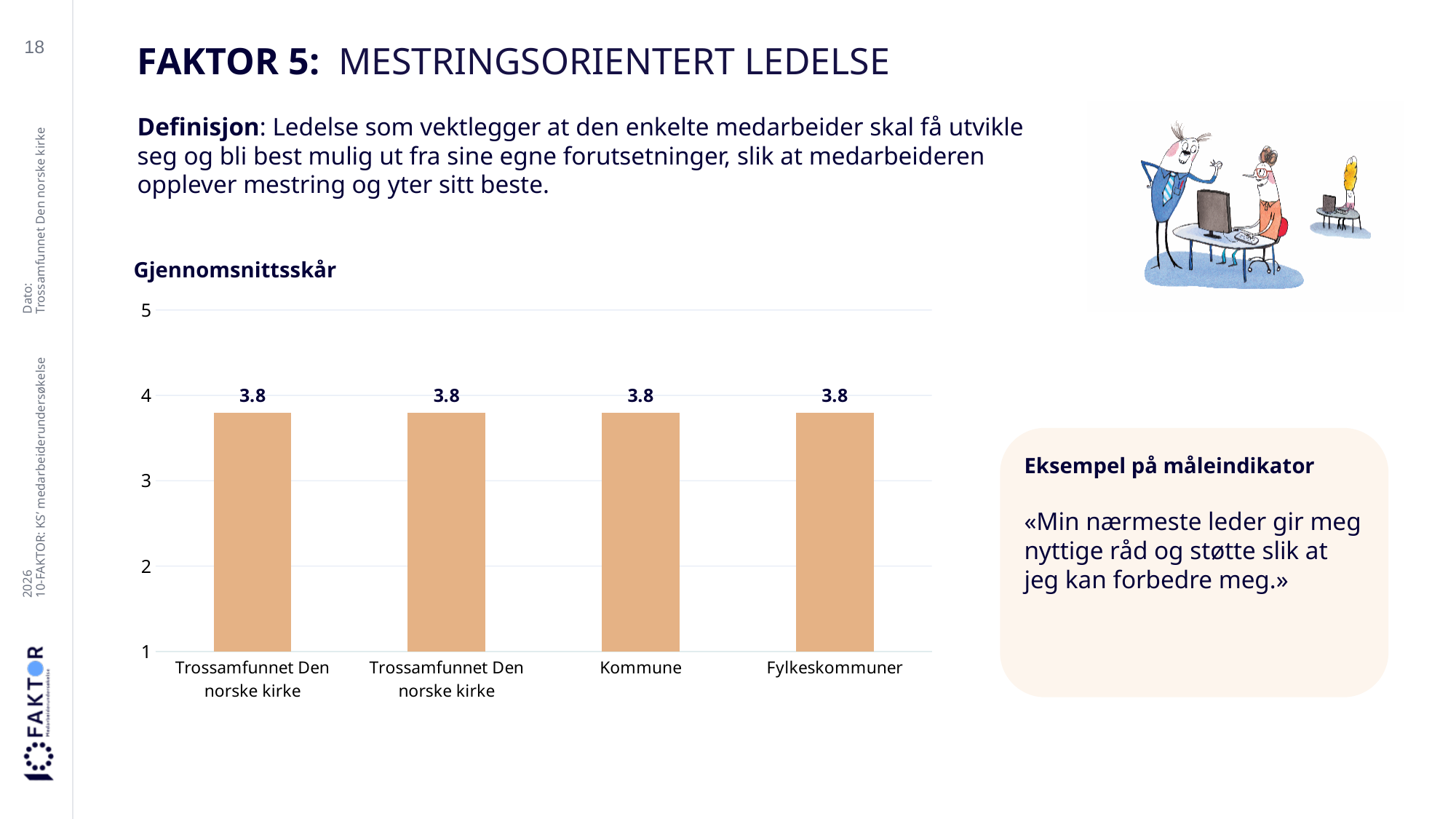
What kind of chart is shown on the slide? Bar chart Is the value for Fylkeskommuner greater or less than 4? less How many bars are shown in the chart? 4 What is the value for Kommune? 3.8 Do the values rise, fall or stay flat across the categories from left to right? Stay flat What is the highest value shown on the vertical axis? 5 What is the value for Fylkeskommuner? 3.8 Is the value for Kommune greater or less than 3? greater What is the value for Trossamfunnet Den norske kirke? 3.8 What is the title of the chart? Gjennomsnittsskår What is the difference between the values for Kommune and Fylkeskommuner? 0